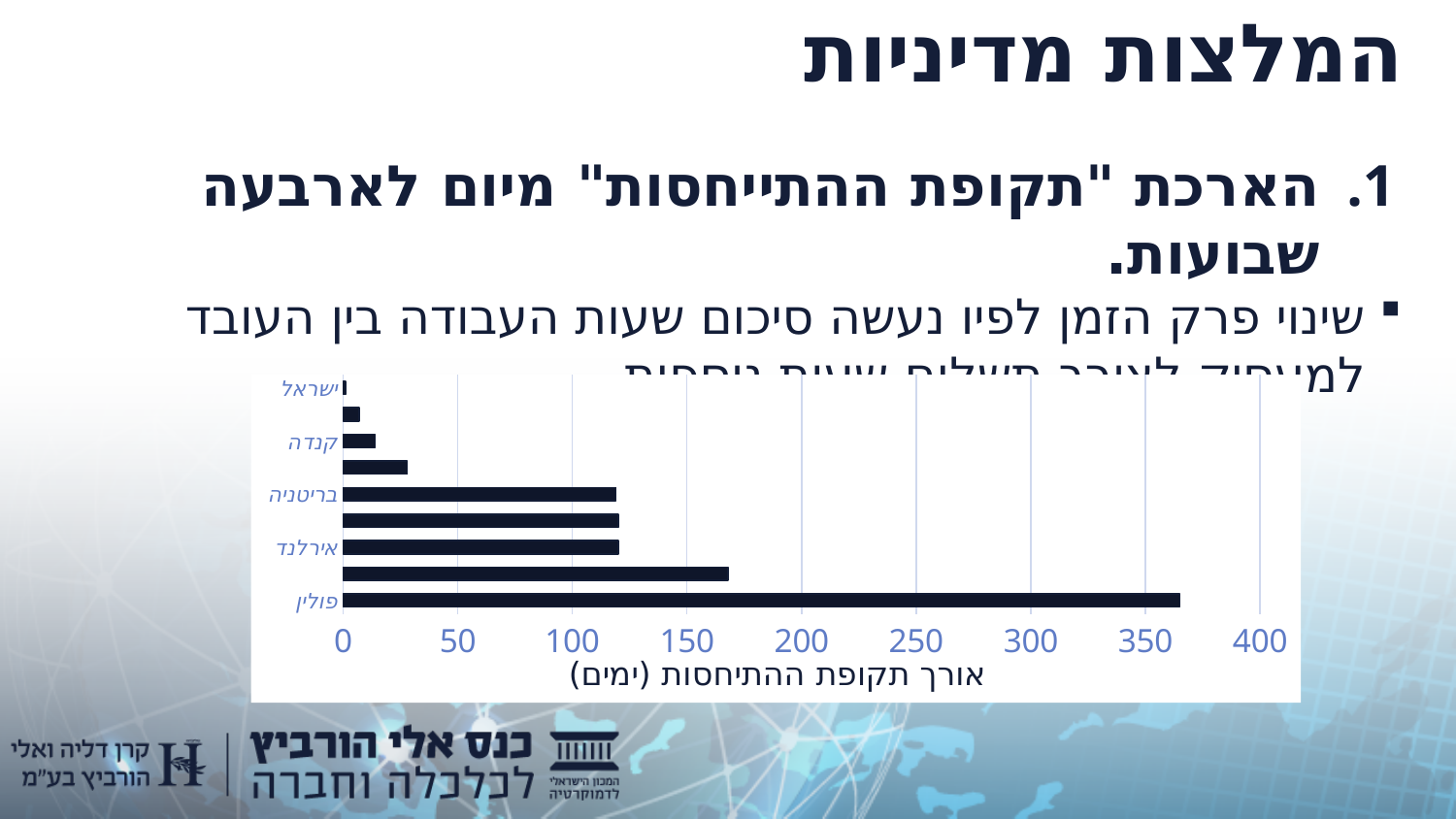
What is the title of the horizontal axis of the chart? אורך תקופת ההתיחסות (ימים) What kind of chart is shown on the slide? bar chart Which has the larger value, פולין or בריטניה? פולין Is the value for אירלנד greater or less than 150? less Which country has the longest bar in the chart? פולין Is the value for בריטניה greater or less than 100? greater Is the value for פולין greater or less than 350? greater Which has the larger value, קנדה or אירלנד? אירלנד Which country has the shortest bar in the chart? ישראל